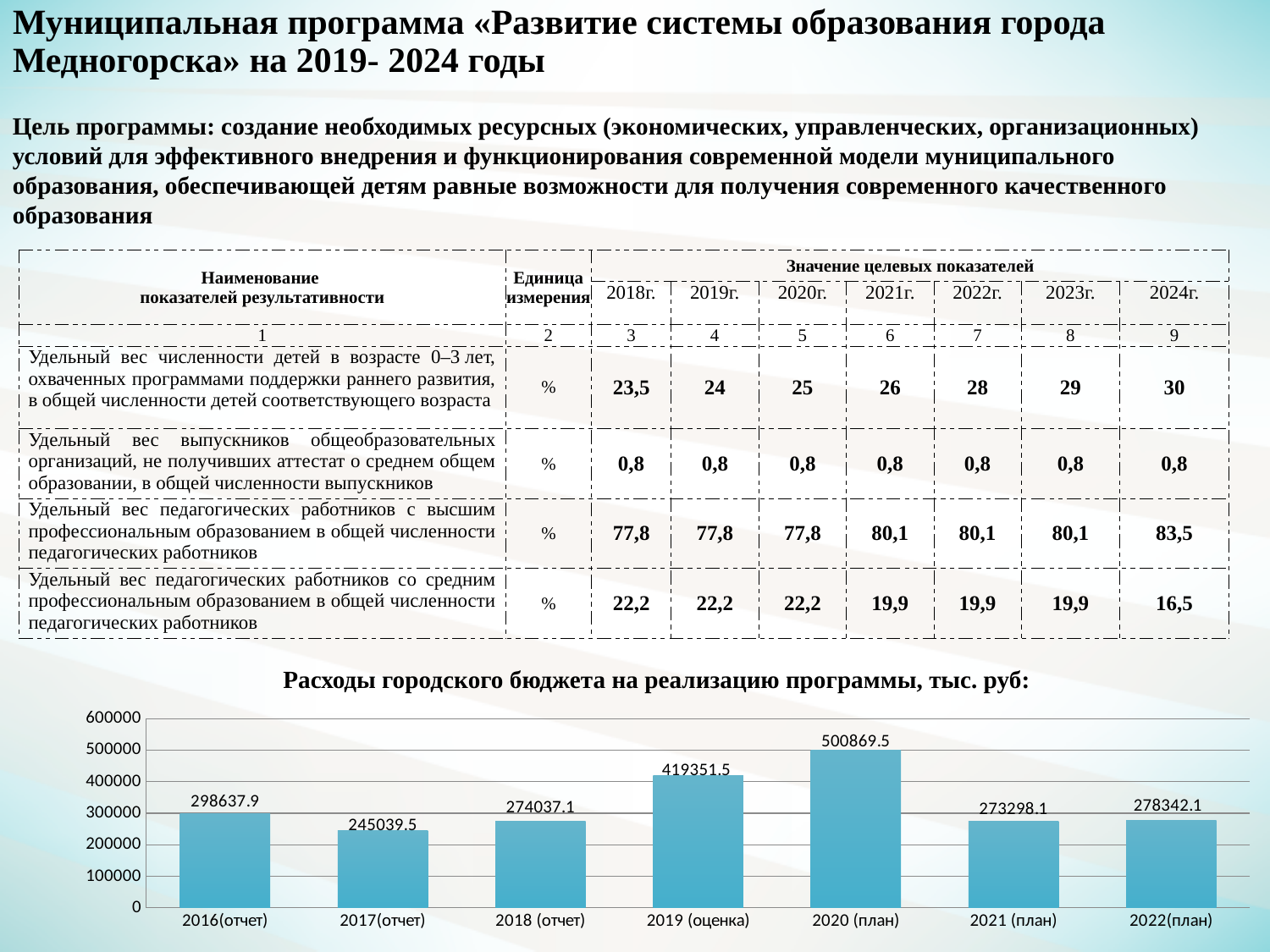
What is the value for 2020 (план) in the chart? 500869.5 What kind of chart is shown on the slide? bar chart Is the value for 2019 (оценка) greater or less than 400000? greater How many categories are shown on the x axis of the chart? 7 What is the value for 2019 (оценка) in the chart? 419351.5 What is the difference between the values for 2020 (план) and 2019 (оценка)? 81518.0 Which category has the lowest value in the chart? 2017(отчет) What is the difference between the values for 2016(отчет) and 2017(отчет)? 53598.4 What is the value for 2017(отчет) in the chart? 245039.5 Which category has the highest value in the chart? 2020 (план) What is the title of the chart? Расходы городского бюджета на реализацию программы, тыс. руб: Which is larger, the value for 2022(план) or the value for 2021 (план)? 2022(план)